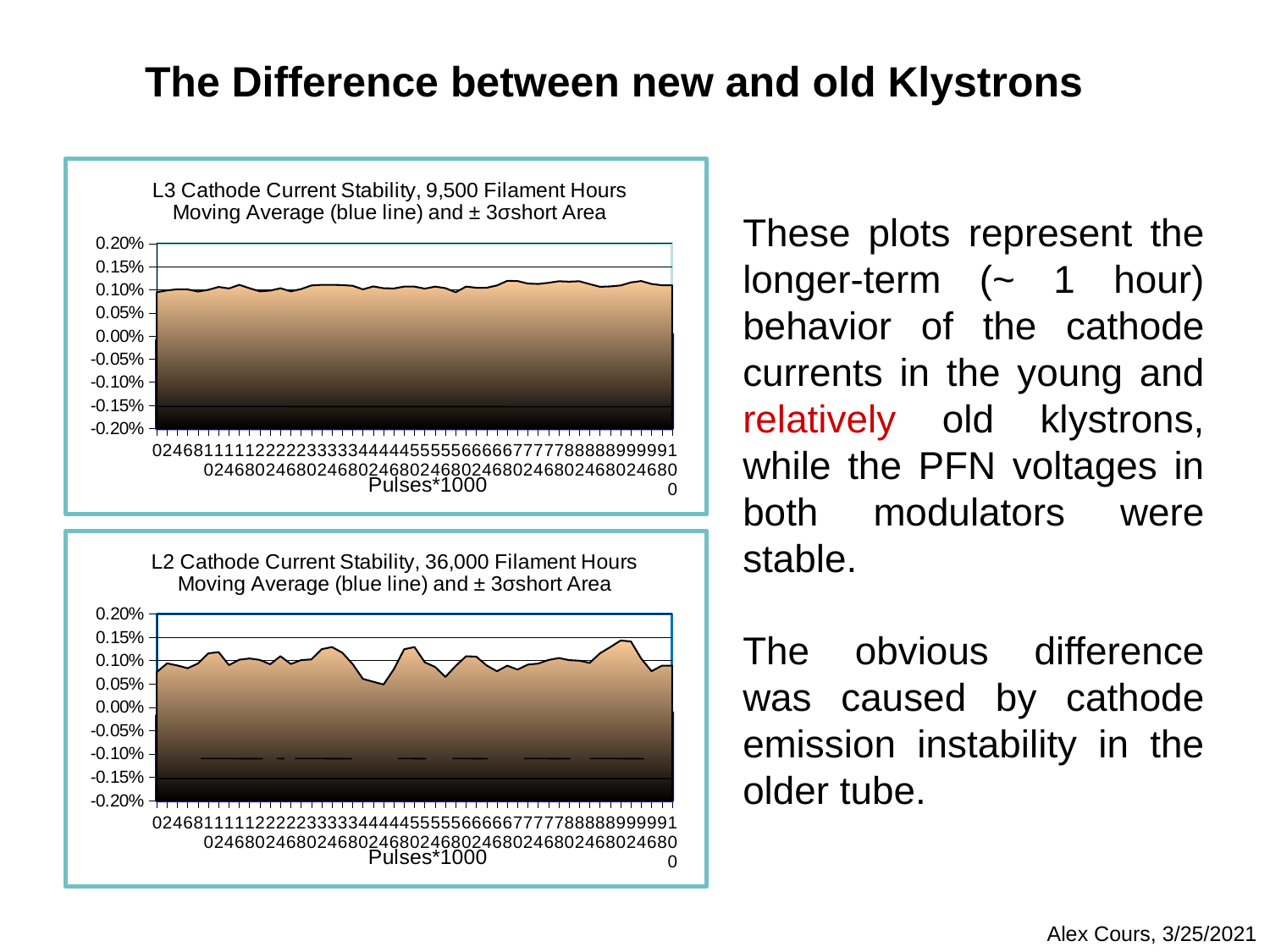
How many filament hours are stated in the title of the bottom chart? 36,000 What kind of chart is the top chart, 'L3 Cathode Current Stability, 9,500 Filament Hours'? Area chart In the bottom chart, 'L2 Cathode Current Stability', is the plotted value across the series greater or less than 0.20%? less Does the plotted value in the top chart, 'L3 Cathode Current Stability', stay roughly flat or fluctuate strongly along the x-axis? Roughly flat What kind of chart is the bottom chart, 'L2 Cathode Current Stability, 36,000 Filament Hours'? Area chart In the top chart, 'L3 Cathode Current Stability', is the plotted value across the series greater or less than 0.15%? less What is the lowest value shown on the y-axis of the bottom chart, 'L2 Cathode Current Stability'? -0.20% What is the x-axis label of the top chart, 'L3 Cathode Current Stability'? Pulses*1000 Which chart shows larger fluctuations in the plotted value, the top chart (L3, 9,500 Filament Hours) or the bottom chart (L2, 36,000 Filament Hours)? The bottom chart (L2, 36,000 Filament Hours)